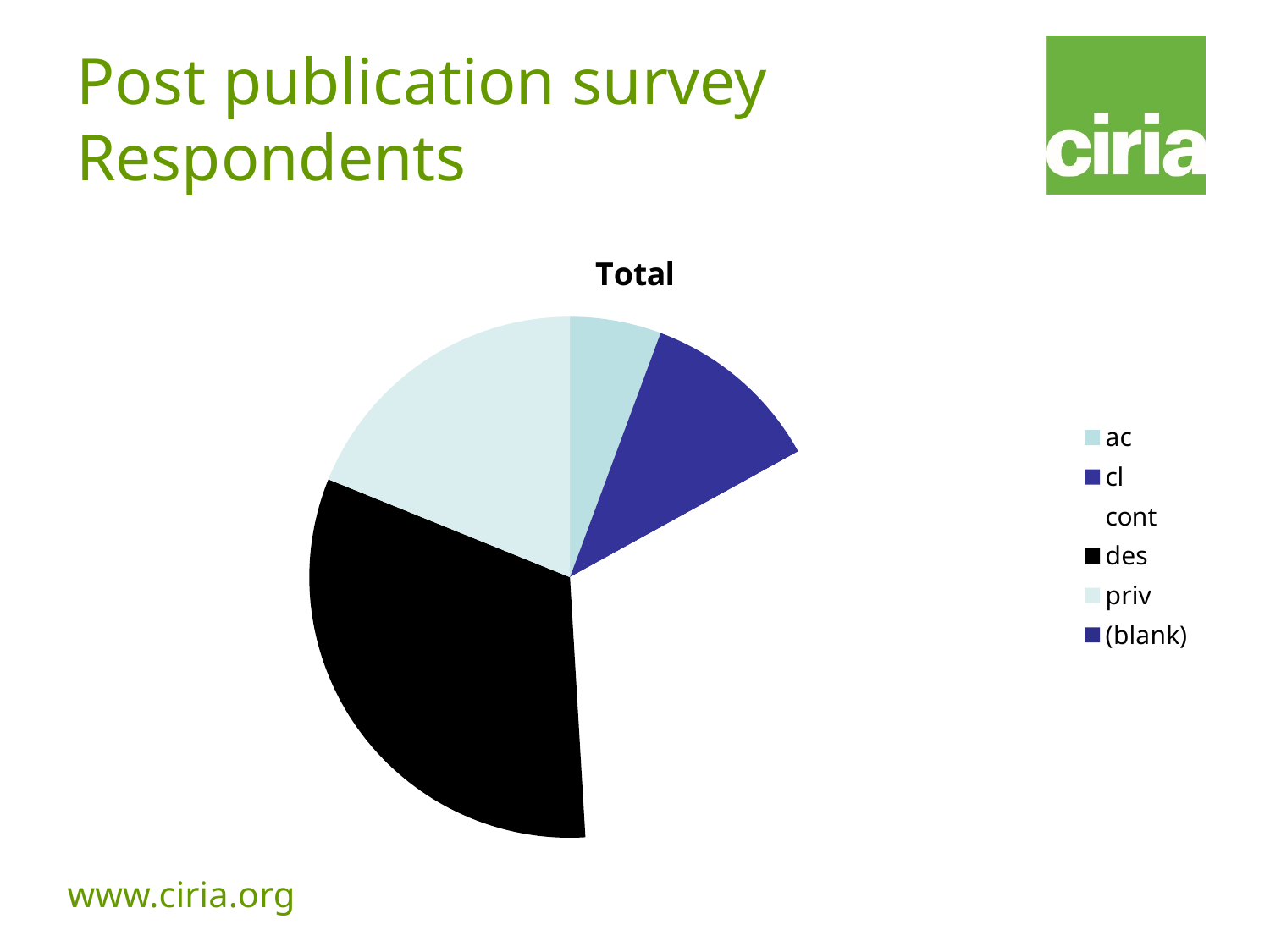
Which slice is larger in the pie chart, des or priv? des Which slice is larger in the pie chart, cl or ac? cl Which legend entry is listed last in the pie chart's legend? (blank) What kind of chart is shown on the slide? pie chart What is the title of the pie chart? Total What colour is the des slice in the pie chart? black Which slice is larger in the pie chart, priv or ac? priv How many entries does the legend of the pie chart list? 6